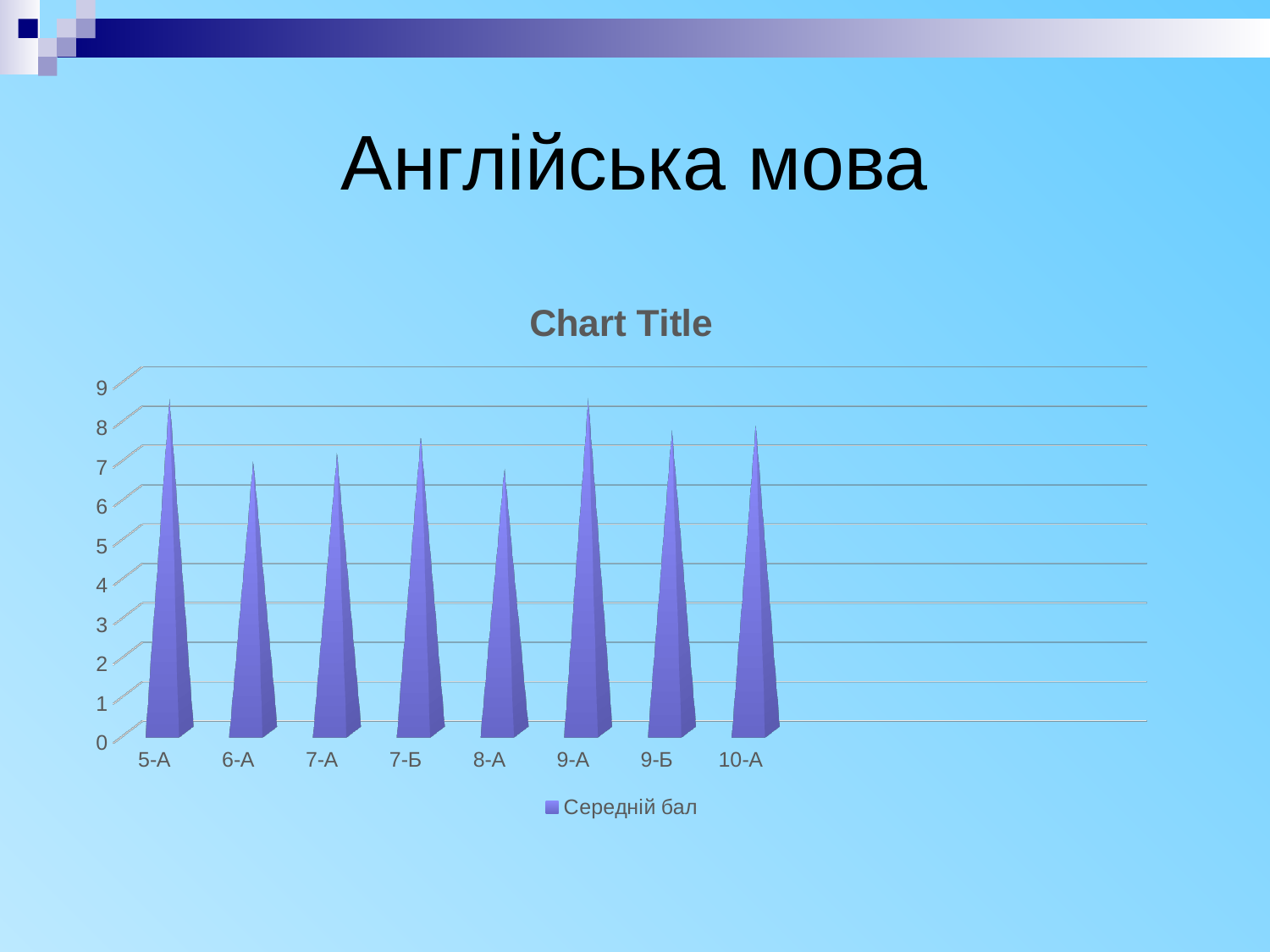
Which has the larger value, 5-А or 6-А? 5-А What is the name of the series shown in the chart's legend? Середній бал How many categories (classes) are shown on the x axis of the chart? 8 What kind of chart is shown on the slide? bar chart Is the value for 8-А greater or less than 8? less How many series does the chart's legend list? 1 Which has the larger value, 10-А or 8-А? 10-А Is the value for 5-А greater or less than 8? greater Is the value for 9-Б greater or less than 7? greater What title is printed above the chart? Chart Title